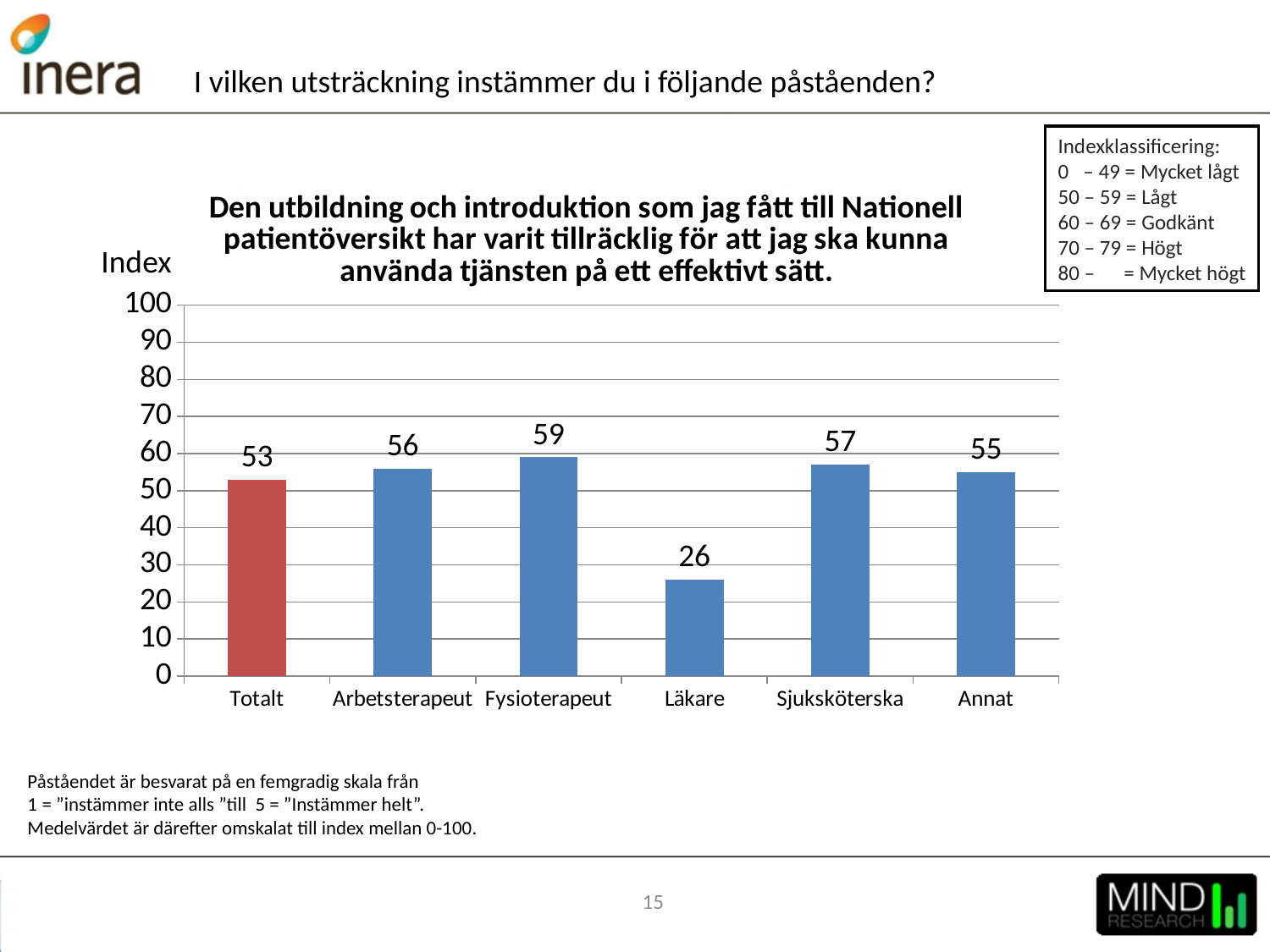
How many categories are shown on the x axis? 6 Which bar is coloured red rather than blue? Totalt What is the index value for Totalt? 53 Which category has the lowest index value? Läkare Which has a higher index value, Sjuksköterska or Annat? Sjuksköterska Which category has the highest index value? Fysioterapeut What is the index value for Läkare? 26 What is the difference between the index values for Arbetsterapeut and Totalt? 3 What kind of chart is shown on the slide? bar chart What is the index value for Sjuksköterska? 57 Is the value for Läkare greater or less than 30? less What is the difference between the index values for Fysioterapeut and Läkare? 33